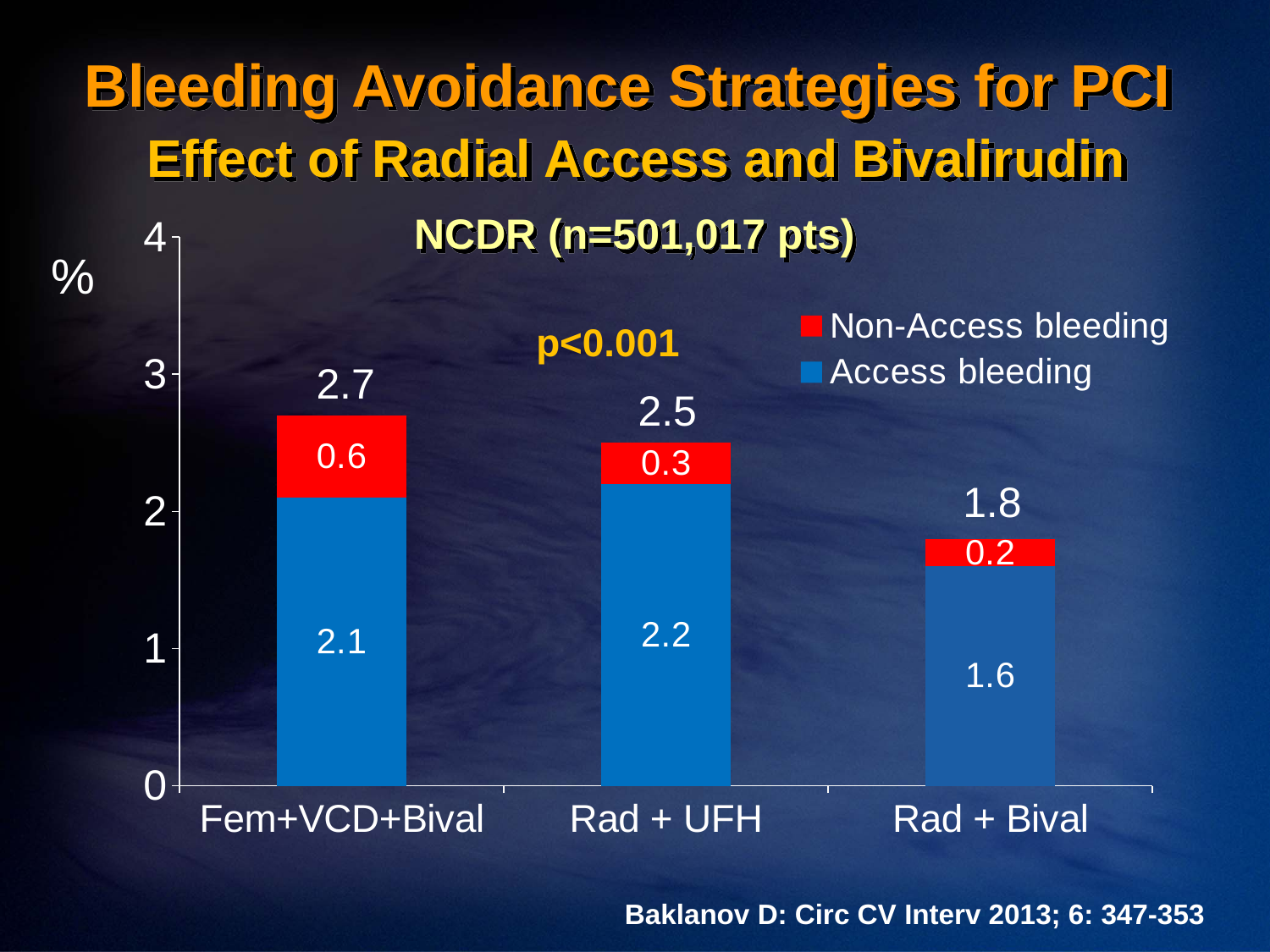
What kind of chart is shown? Stacked bar chart How many categories are shown on the x axis? 3 Which category has the highest total bleeding? Fem+VCD+Bival What is the Non-Access bleeding value for Rad + UFH? 0.3 What is the Access bleeding value for Rad + Bival? 1.6 What is the total of the stacked bar for Rad + Bival? 1.8 What is the difference between the total for Fem+VCD+Bival and the total for Rad + Bival? 0.9 How many series does the legend list? 2 Which colour represents Non-Access bleeding in the legend? Red Which is larger, the Access bleeding value for Rad + UFH or for Fem+VCD+Bival? Rad + UFH Which category has the lowest Non-Access bleeding value? Rad + Bival What is the Access bleeding value for Fem+VCD+Bival? 2.1